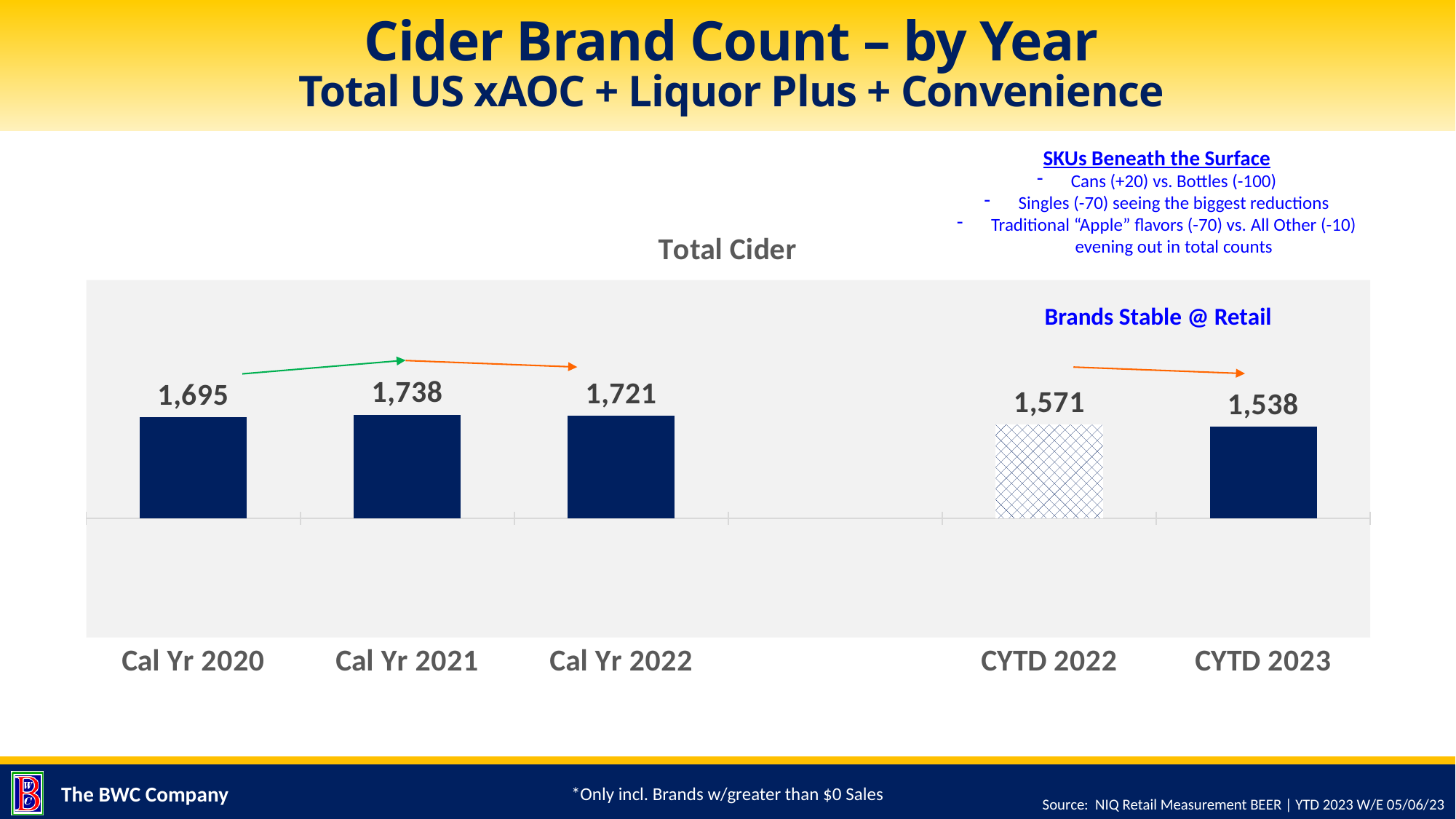
What kind of chart is shown on the slide? Bar chart Which category has the highest Total Cider brand count? Cal Yr 2021 What is the Total Cider brand count for CYTD 2023? 1,538 What is the Total Cider brand count for Cal Yr 2021? 1,738 What is the Total Cider brand count for Cal Yr 2020? 1,695 What is the difference in brand count between Cal Yr 2021 and Cal Yr 2022? 17 Which is larger, the brand count for Cal Yr 2020 or for Cal Yr 2022? Cal Yr 2022 How many bars are plotted in the Total Cider chart? 5 Does the brand count rise or fall from CYTD 2022 to CYTD 2023? Fall What is the difference in brand count between CYTD 2022 and CYTD 2023? 33 Which category has the lowest Total Cider brand count? CYTD 2023 What is the title of the chart on the slide? Total Cider